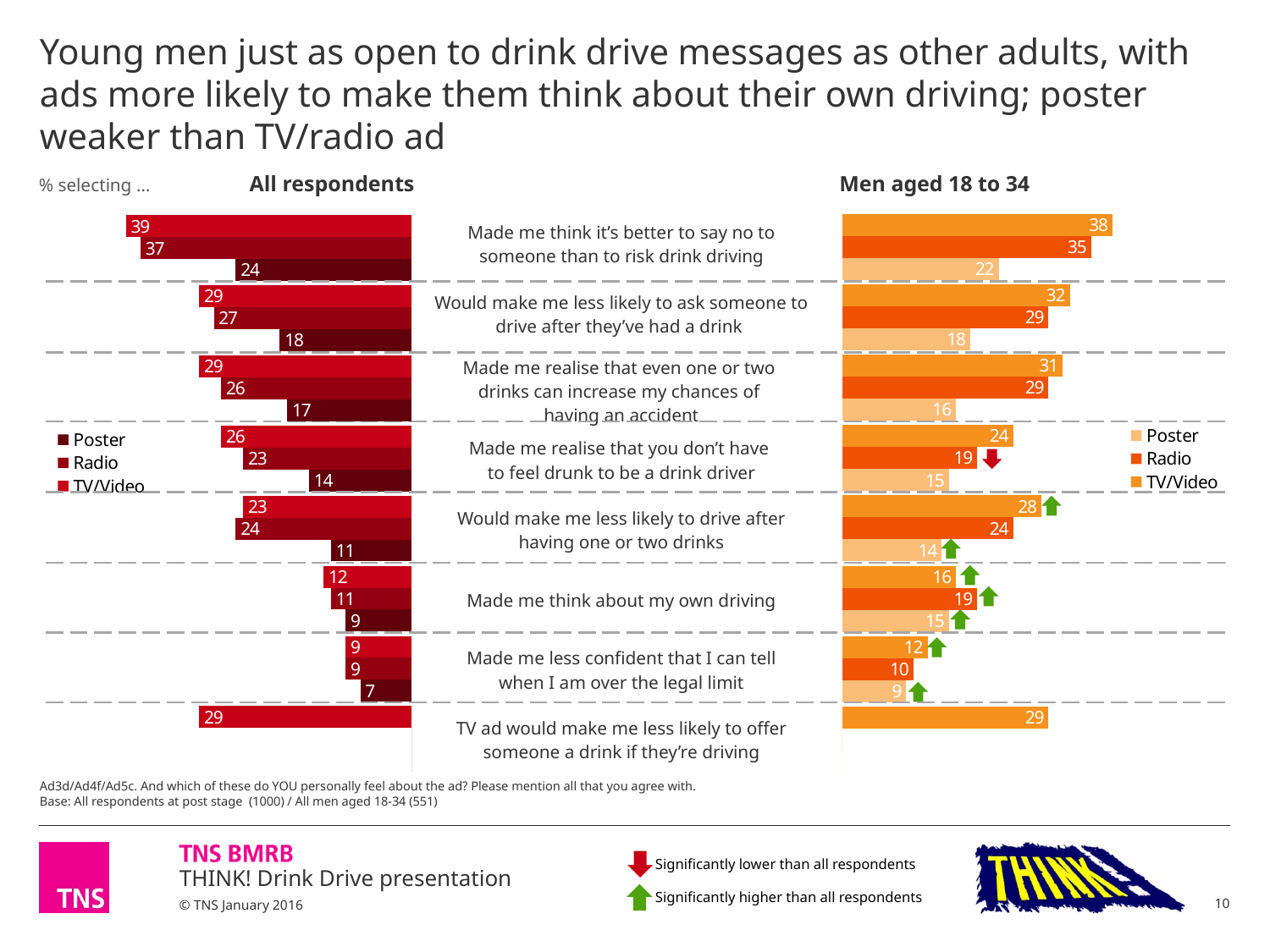
In the Men aged 18 to 34 chart, which statement has the highest value? Made me think it's better to say no to someone than to risk drink driving How many statements are plotted in the Men aged 18 to 34 chart? 8 In the All respondents chart, what is the value of the bottom bar for 'Made me think about my own driving'? 9 What are the three legend entries shown for the charts? Poster, Radio, TV/Video In the Men aged 18 to 34 chart, what is the value of the middle bar for 'Made me realise that you don't have to feel drunk to be a drink driver'? 19 In the Men aged 18 to 34 chart, what is the value for 'TV ad would make me less likely to offer someone a drink if they're driving'? 29 According to the key at the bottom of the slide, what does a green up arrow indicate? Significantly higher than all respondents In the All respondents chart, what is the difference between the top bar (39) and the bottom bar (24) for 'Made me think it's better to say no to someone than to risk drink driving'? 15 What kind of chart is used on this slide? Bar chart In the All respondents chart, what is the value of the bottom bar for 'Made me less confident that I can tell when I am over the legal limit'? 7 How many series does the legend list for the All respondents chart? 3 For 'Would make me less likely to drive after having one or two drinks', is the top bar larger in the All respondents chart (23) or the Men aged 18 to 34 chart (28)? Men aged 18 to 34